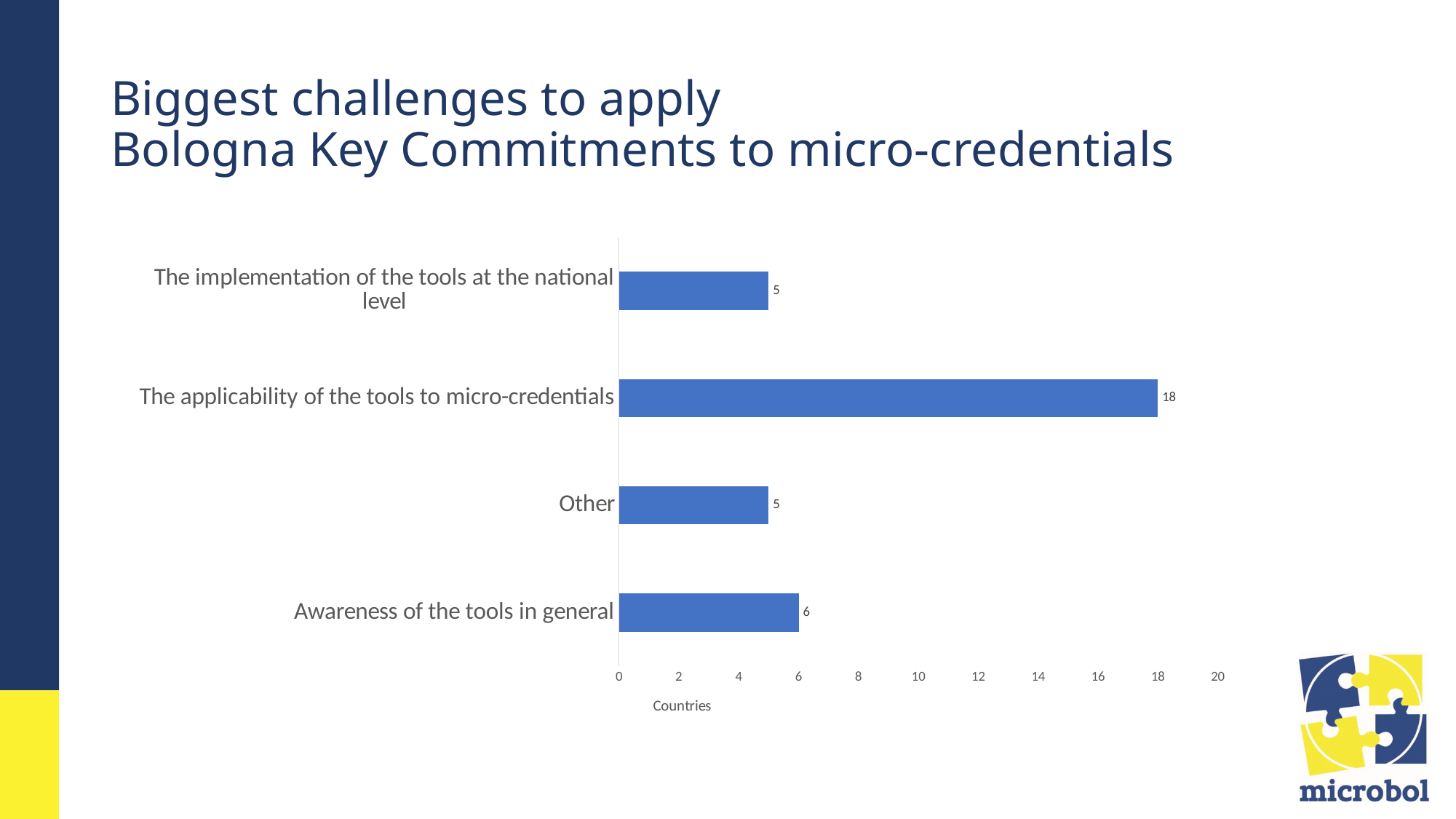
What is the label of the horizontal axis? Countries What is the maximum value shown on the horizontal axis? 20 How many categories are shown in the chart? 4 Is the value for 'The applicability of the tools to micro-credentials' greater or less than 10? greater What is the value for 'The implementation of the tools at the national level'? 5 Which is larger: the value for 'Awareness of the tools in general' or the value for 'Other'? Awareness of the tools in general What kind of chart is shown on the slide? Bar chart What is the difference between the values for 'The applicability of the tools to micro-credentials' and 'Awareness of the tools in general'? 12 How many countries cited 'The applicability of the tools to micro-credentials' as a challenge? 18 Which challenge has the highest number of countries? The applicability of the tools to micro-credentials What is the value for 'Awareness of the tools in general'? 6 What is the value for 'Other'? 5